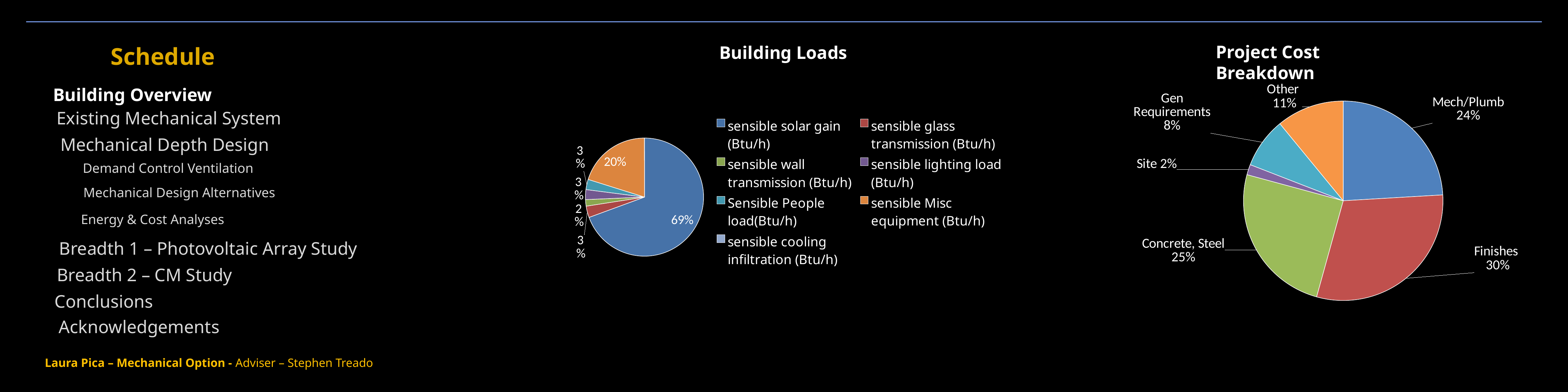
In the Project Cost Breakdown chart, what share is Mech/Plumb? 24% In the Building Loads chart, what share of the pie is sensible Misc equipment (Btu/h)? 20% In the Project Cost Breakdown chart, how many percentage points larger is Finishes than Mech/Plumb? 6 In the Project Cost Breakdown chart, which category has the smallest slice? Site In the Project Cost Breakdown chart, what share is Concrete, Steel? 25% In the Building Loads chart, which category has the largest slice? sensible solar gain (Btu/h) How many categories are shown in the Project Cost Breakdown chart? 6 What kind of chart is the Building Loads chart? Pie chart In the Project Cost Breakdown chart, which is larger: Other or Gen Requirements? Other How many entries does the legend of the Building Loads chart list? 7